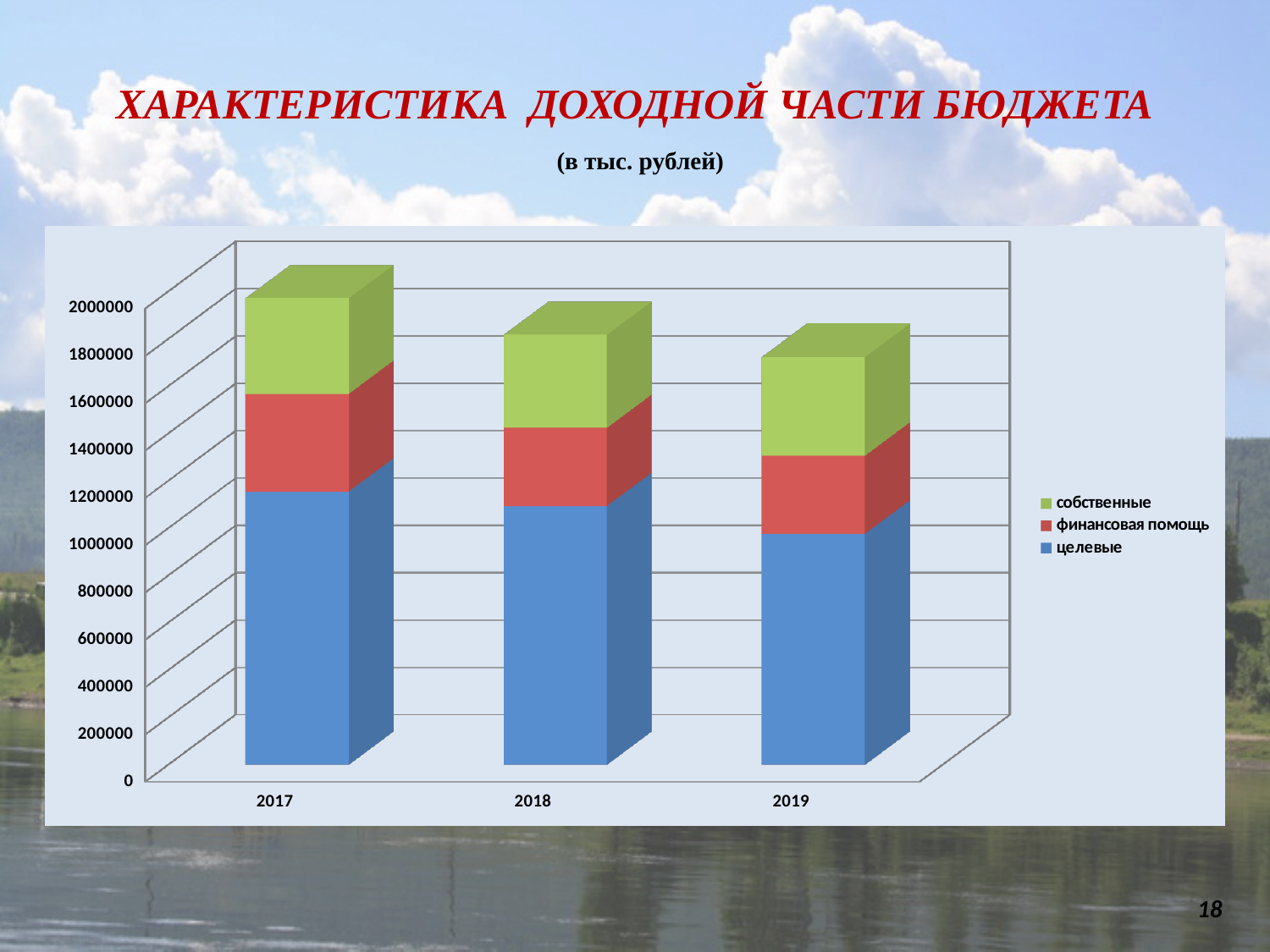
Do the total bar heights rise or fall from 2017 to 2019? fall Is the value of целевые for 2019 greater or less than 800000? greater Is the total for 2019 greater or less than 1600000? greater Which is larger, the целевые value for 2017 or for 2019? 2017 Is the value of целевые for 2017 greater or less than 1000000? greater How many years are shown on the x axis? 3 Which series is shown in green in the legend? собственные How many series does the legend list? 3 Which year has the highest total bar? 2017 What kind of chart is shown on the slide? stacked bar chart Which year has the lowest total bar? 2019